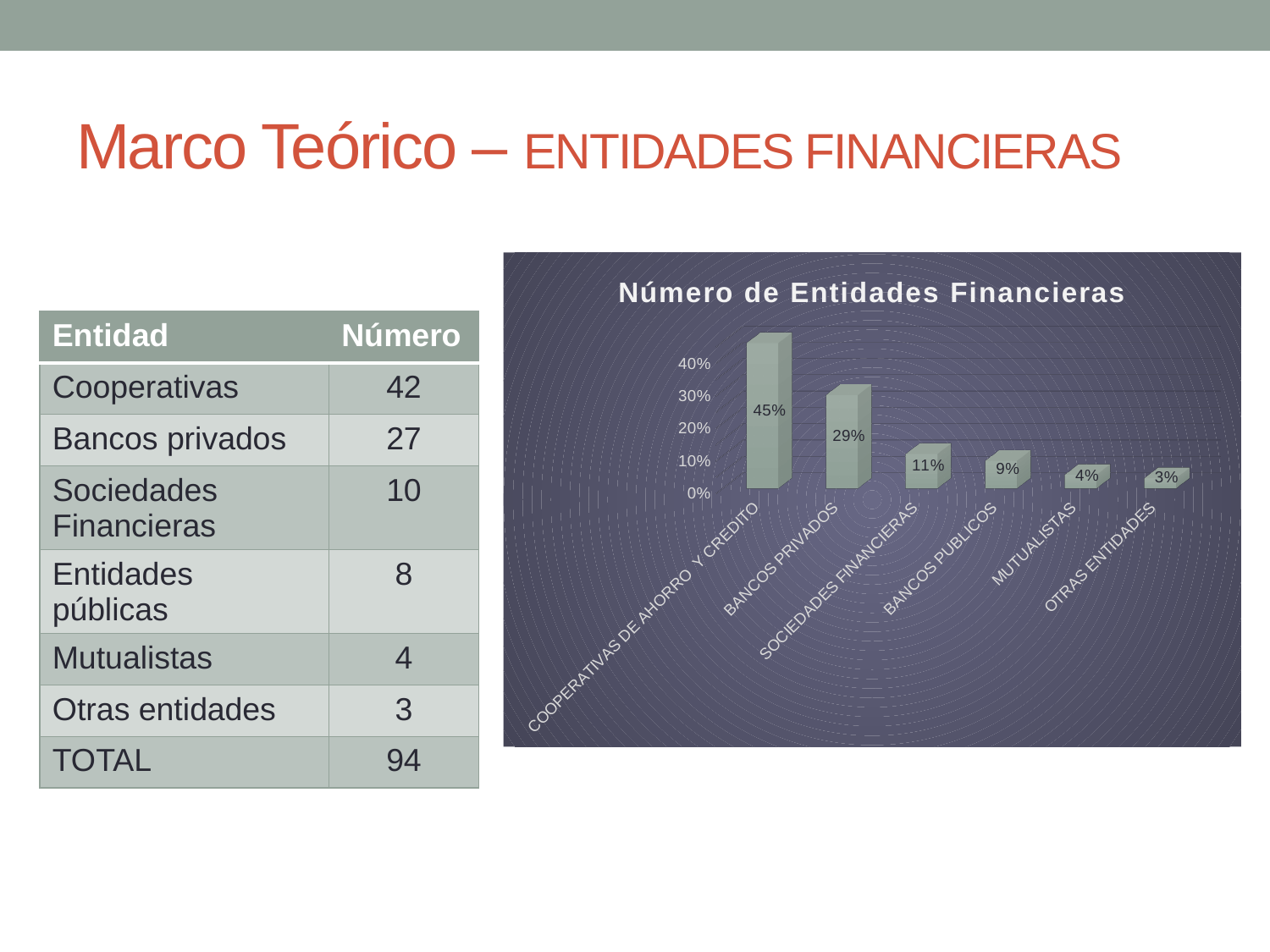
What is the value for SOCIEDADES FINANCIERAS in the chart? 11% Which category has the lowest value in the chart? OTRAS ENTIDADES Is the value for BANCOS PRIVADOS greater or less than 20%? greater What is the value for MUTUALISTAS in the chart? 4% Do the values rise or fall from left to right along the x axis? fall What type of chart is shown on the slide? bar chart What is the difference between the values for COOPERATIVAS DE AHORRO Y CREDITO and BANCOS PRIVADOS? 16% Which is larger, the value for BANCOS PUBLICOS or the value for SOCIEDADES FINANCIERAS? SOCIEDADES FINANCIERAS How many categories are shown in the chart? 6 Which category has the highest value in the chart? COOPERATIVAS DE AHORRO Y CREDITO What is the value for BANCOS PRIVADOS in the chart? 29% What is the title of the chart? Número de Entidades Financieras